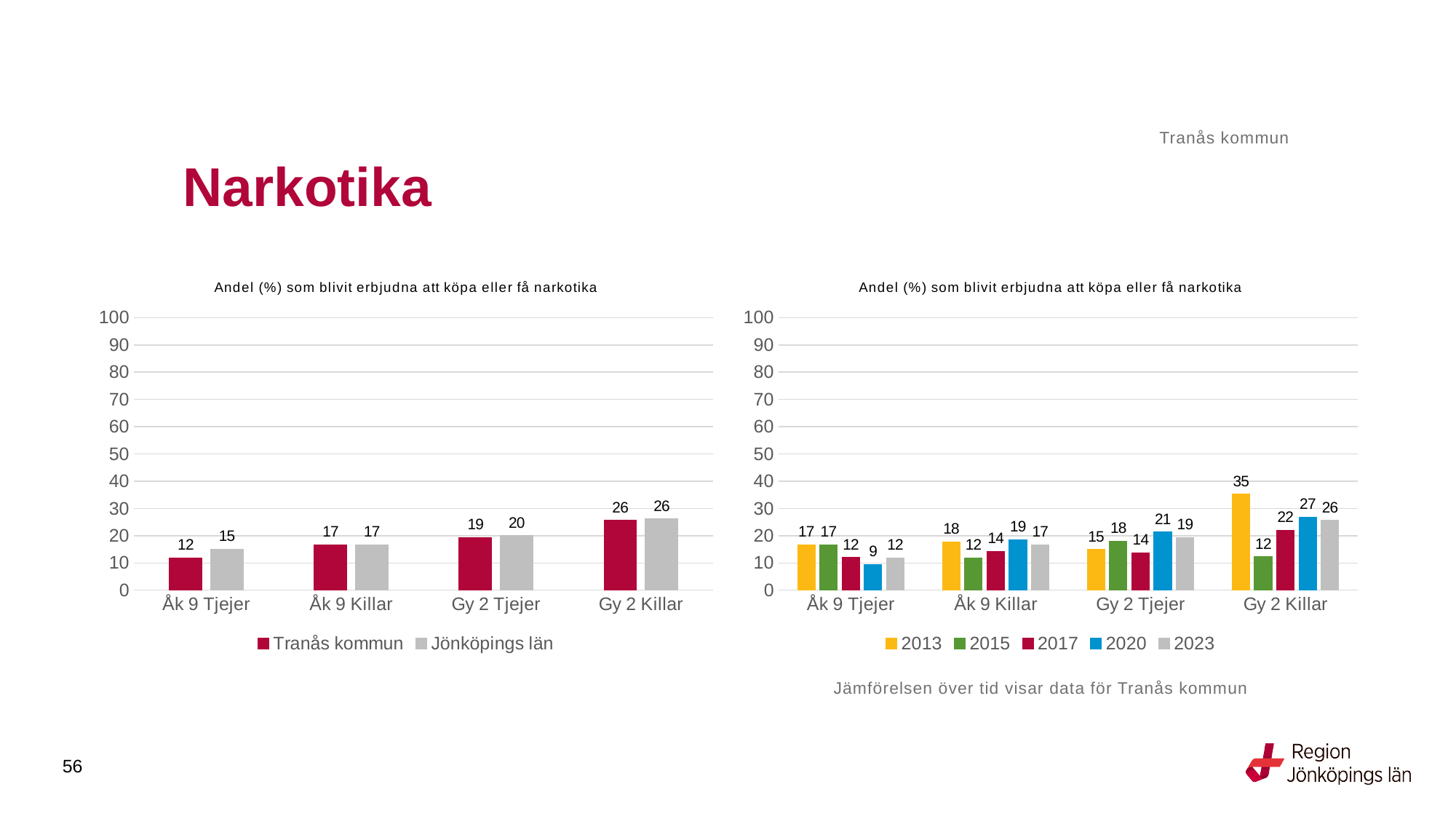
In the left chart, what is the value for Jönköpings län for Gy 2 Tjejer? 20 What kind of chart is the left chart? Bar chart In the right chart, which category has the lowest value for 2020? Åk 9 Tjejer In the right chart, how many series does the legend list? 5 In the left chart, which category has the highest value for Tranås kommun? Gy 2 Killar In the left chart, what is the value for Tranås kommun for Åk 9 Tjejer? 12 In the right chart, is the value for 2013 for Gy 2 Killar larger or smaller than the value for 2015 for Gy 2 Killar? Larger In the left chart, how many series does the legend list? 2 In the right chart, how many categories are shown on the x axis? 4 In the left chart, what is the difference between Jönköpings län and Tranås kommun for Åk 9 Tjejer? 3 In the right chart, what is the value for 2013 for Gy 2 Killar? 35 In the right chart, what is the value for 2020 for Åk 9 Tjejer? 9